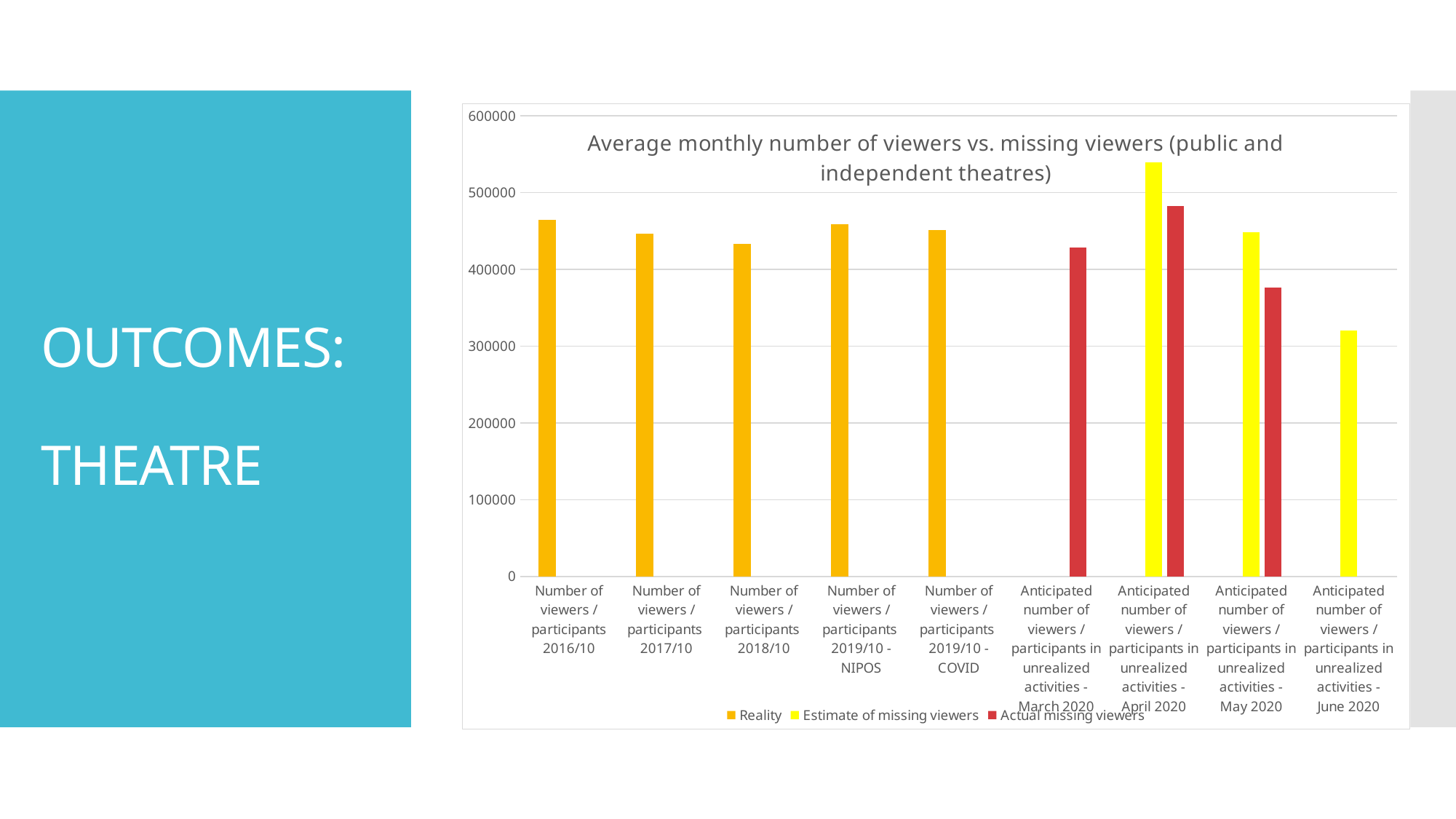
Which Reality bar is taller: 2016/10 or 2018/10? 2016/10 Is the Estimate of missing viewers for June 2020 greater or less than 300000? greater Is the Actual missing viewers value for May 2020 greater or less than 400000? less How many series does the legend list? 3 For April 2020, which is larger: the Estimate of missing viewers or the Actual missing viewers? Estimate of missing viewers Is the Reality value for 'Number of viewers / participants 2016/10' greater or less than 400000? greater What kind of chart is shown on the slide? Bar chart Which bar is the tallest in the chart? Estimate of missing viewers, April 2020 Which bar is the shortest in the chart? Estimate of missing viewers, June 2020 What is the title of the chart? Average monthly number of viewers vs. missing viewers (public and independent theatres) How many categories are shown along the x axis? 9